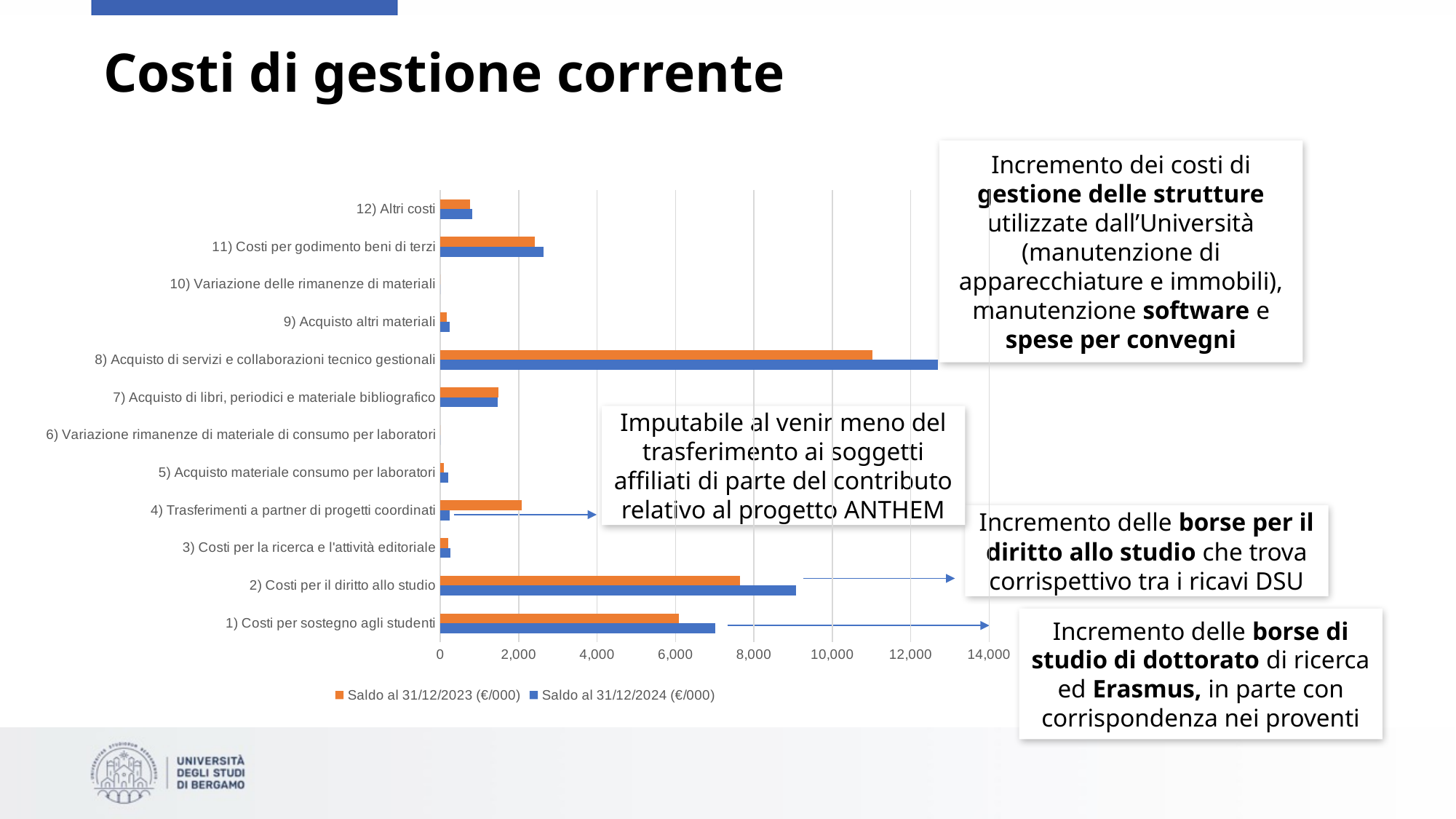
Is the Saldo al 31/12/2024 (€/000) value for 2) Costi per il diritto allo studio greater or less than 8,000? greater Is the Saldo al 31/12/2024 (€/000) value for 8) Acquisto di servizi e collaborazioni tecnico gestionali greater or less than 12,000? greater Is the Saldo al 31/12/2023 (€/000) value for 2) Costi per il diritto allo studio greater or less than 8,000? less For 1) Costi per sostegno agli studenti, which series has the larger value: Saldo al 31/12/2023 (€/000) or Saldo al 31/12/2024 (€/000)? Saldo al 31/12/2024 (€/000) Which category has the highest value for Saldo al 31/12/2023 (€/000)? 8) Acquisto di servizi e collaborazioni tecnico gestionali What kind of chart is shown on the slide? bar chart Which colour represents the series Saldo al 31/12/2024 (€/000) in the chart? blue How many series does the legend list? 2 Which category has the highest value for Saldo al 31/12/2024 (€/000)? 8) Acquisto di servizi e collaborazioni tecnico gestionali How many categories are listed on the vertical axis of the chart? 12 For 4) Trasferimenti a partner di progetti coordinati, which series has the larger value: Saldo al 31/12/2023 (€/000) or Saldo al 31/12/2024 (€/000)? Saldo al 31/12/2023 (€/000)